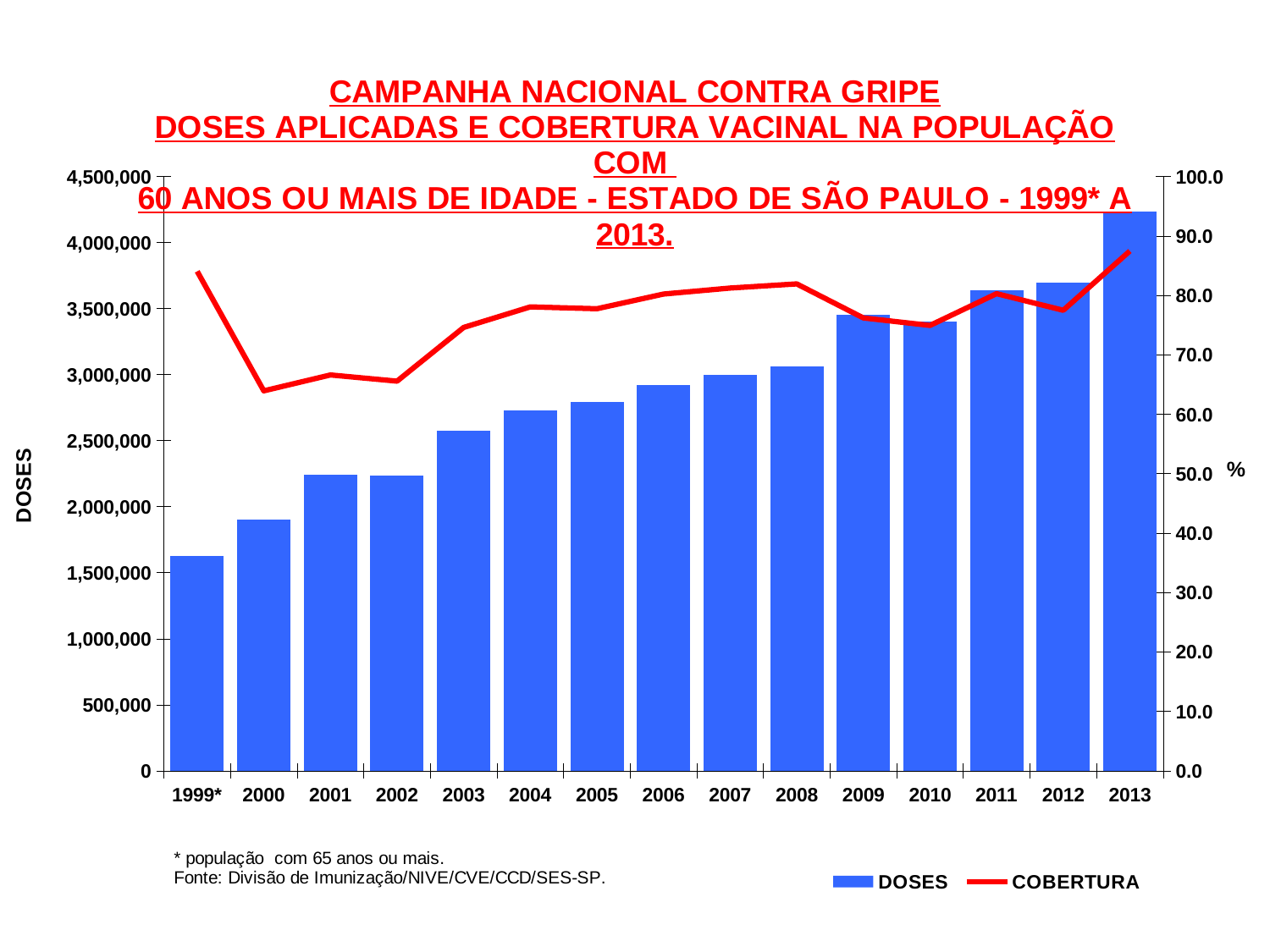
What kind of chart is shown on the slide? A bar chart combined with a line Which year has more DOSES, 2008 or 2011? 2011 Do the DOSES values generally rise or fall from 1999* to 2013? rise Which year has the lowest number of DOSES? 1999* How many years are shown along the x axis? 15 Is the DOSES value for 2013 greater or less than 4,000,000? greater What are the two entries listed in the legend? DOSES and COBERTURA Which year has the highest number of DOSES? 2013 How many series does the legend list? 2 Which year has the highest COBERTURA value? 2013 Is the DOSES value for 2000 greater or less than 2,000,000? less Is the COBERTURA value for 2000 greater or less than 70.0? less